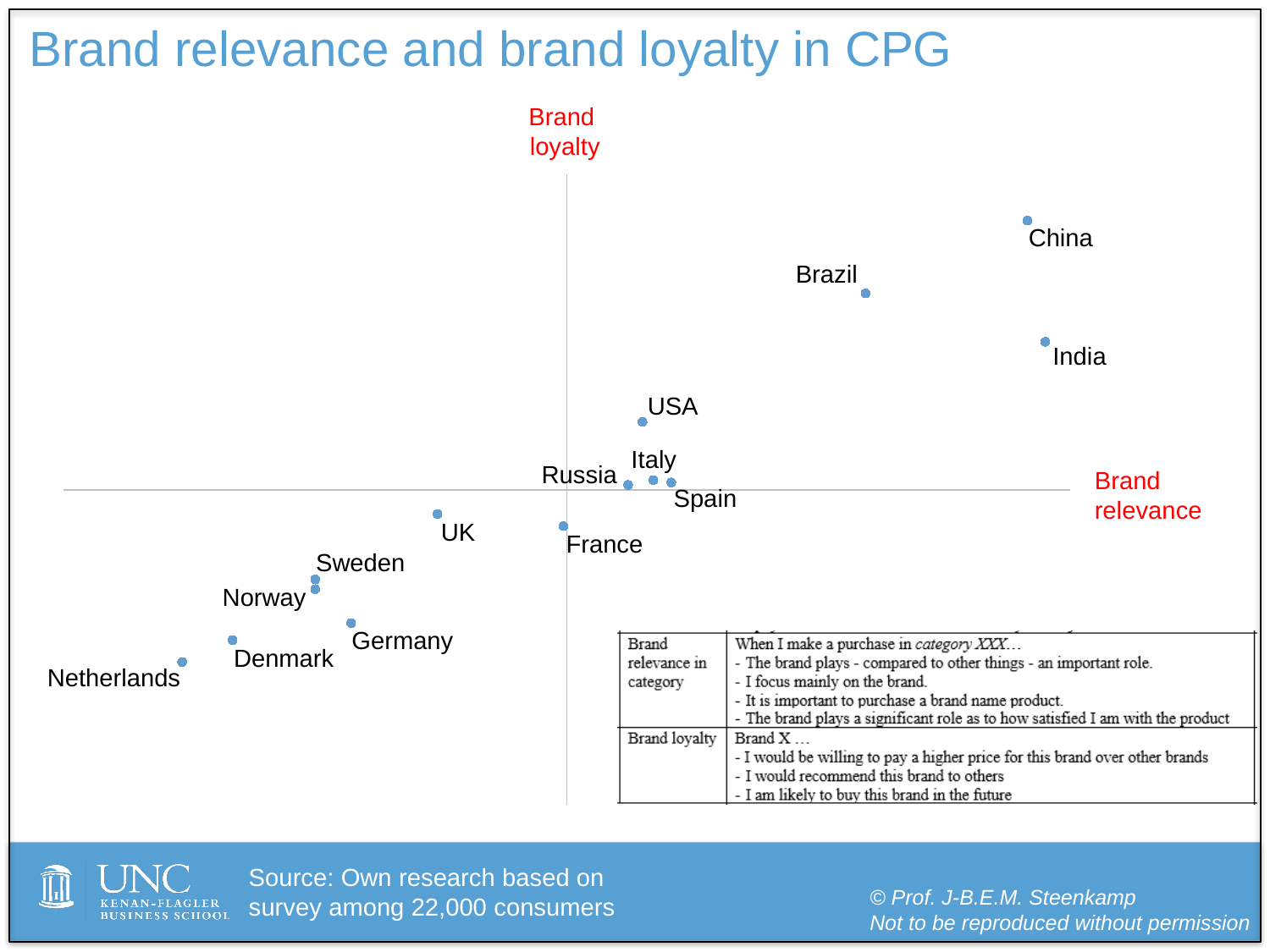
What is the title of the slide? Brand relevance and brand loyalty in CPG Which country has the lowest brand loyalty on the chart? Netherlands Which has higher brand loyalty, China or India? China Which country has the highest brand loyalty on the chart? China Which country has the lowest brand relevance on the chart? Netherlands Which has higher brand loyalty, Brazil or USA? Brazil Do the points generally rise or fall as brand relevance increases along the x axis? Rise How many countries are plotted on the chart? 14 What kind of chart is shown on the slide? Scatter chart What is the label of the vertical axis? Brand loyalty Which has higher brand relevance, Germany or Netherlands? Germany